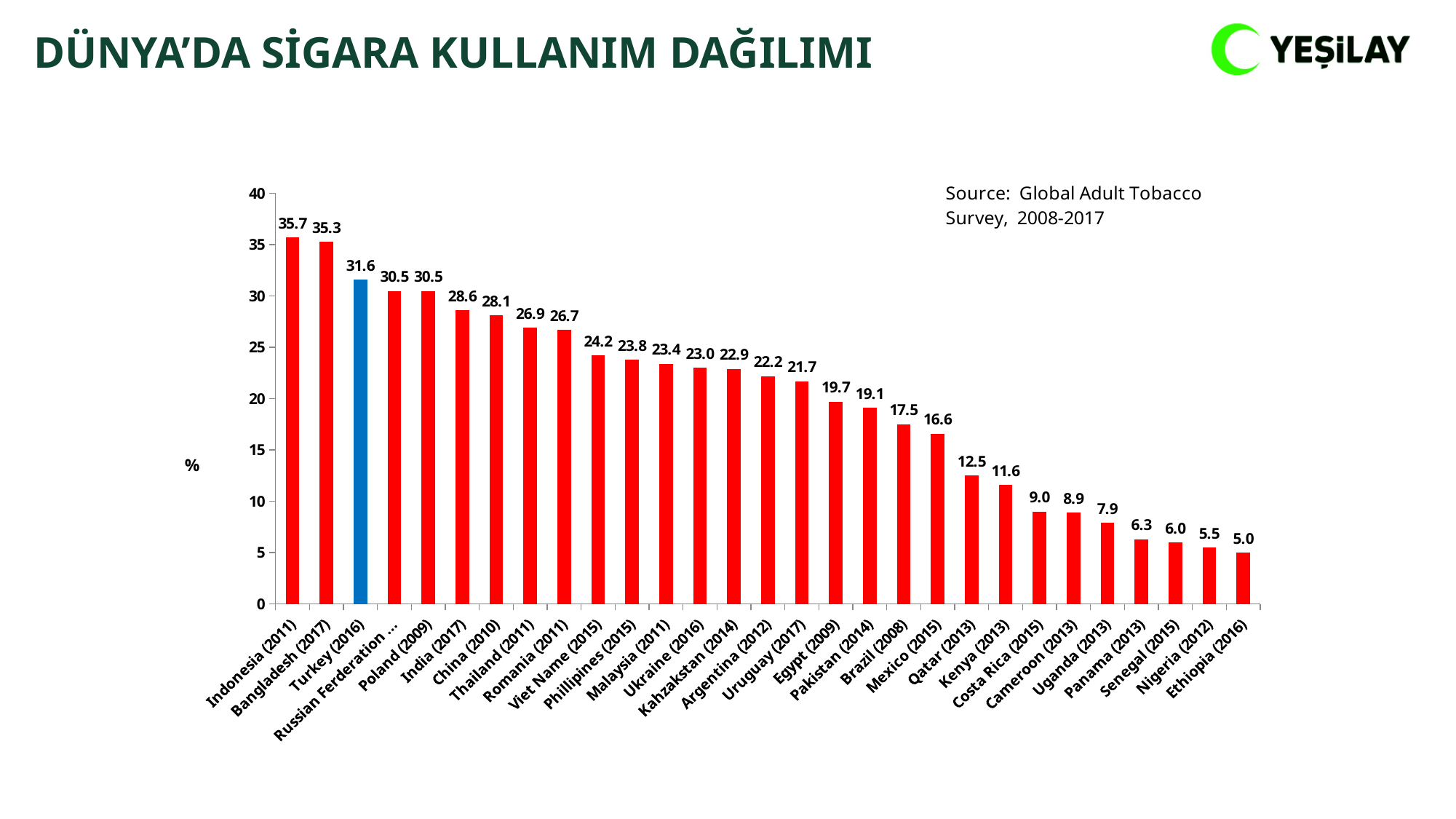
Which country has the lowest value? Ethiopia (2016) Which country's bar is coloured blue instead of red? Turkey (2016) Which is larger, the value for Egypt (2009) or the value for Brazil (2008)? Egypt (2009) What is the difference between the values for Indonesia (2011) and Bangladesh (2017)? 0.4 How many countries are shown in the chart? 29 What kind of chart is shown on the slide? Bar chart What is the value for Turkey (2016)? 31.6 Do the values rise or fall from left to right along the x axis? Fall Which country has the highest value? Indonesia (2011) What is the difference between the values for Turkey (2016) and Ethiopia (2016)? 26.6 What is the value for India (2017)? 28.6 What is the value for Mexico (2015)? 16.6